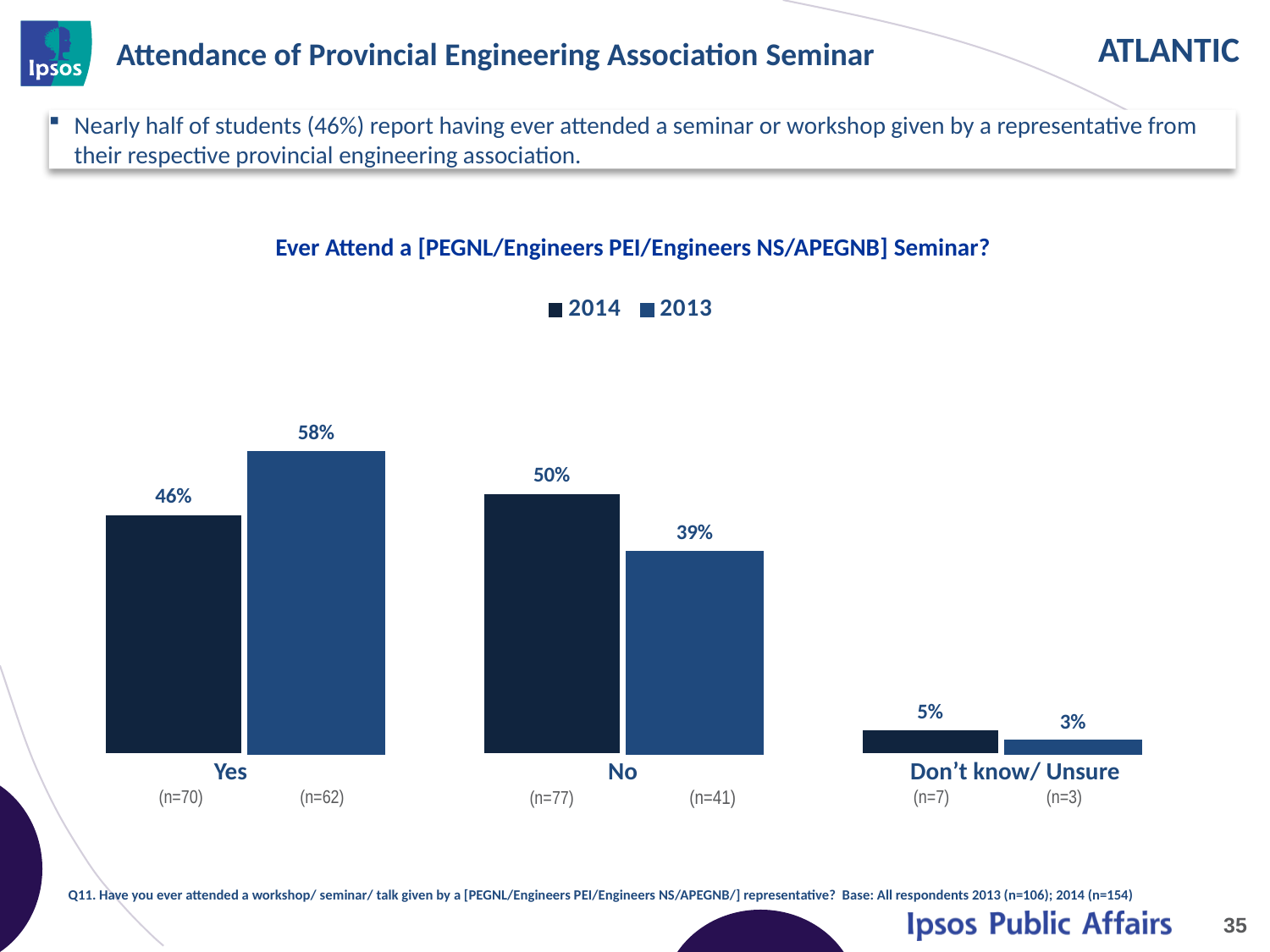
Which category has the lowest value for 2013? Don't know/ Unsure How many response categories are shown on the x axis? 3 Which category has the highest value for 2014? No What percentage of students answered "Yes" in 2014? 46% What percentage of students answered "Yes" in 2013? 58% Which is larger for "No": the 2014 value or the 2013 value? 2014 What is the difference between the 2013 and 2014 values for "Yes"? 12 percentage points What is the 2014 value for "Don't know/ Unsure"? 5% How many series does the legend list? 2 What type of chart is shown on the slide? Bar chart What is the difference between the 2014 and 2013 values for "No"? 11 percentage points What is the 2013 value for "No"? 39%